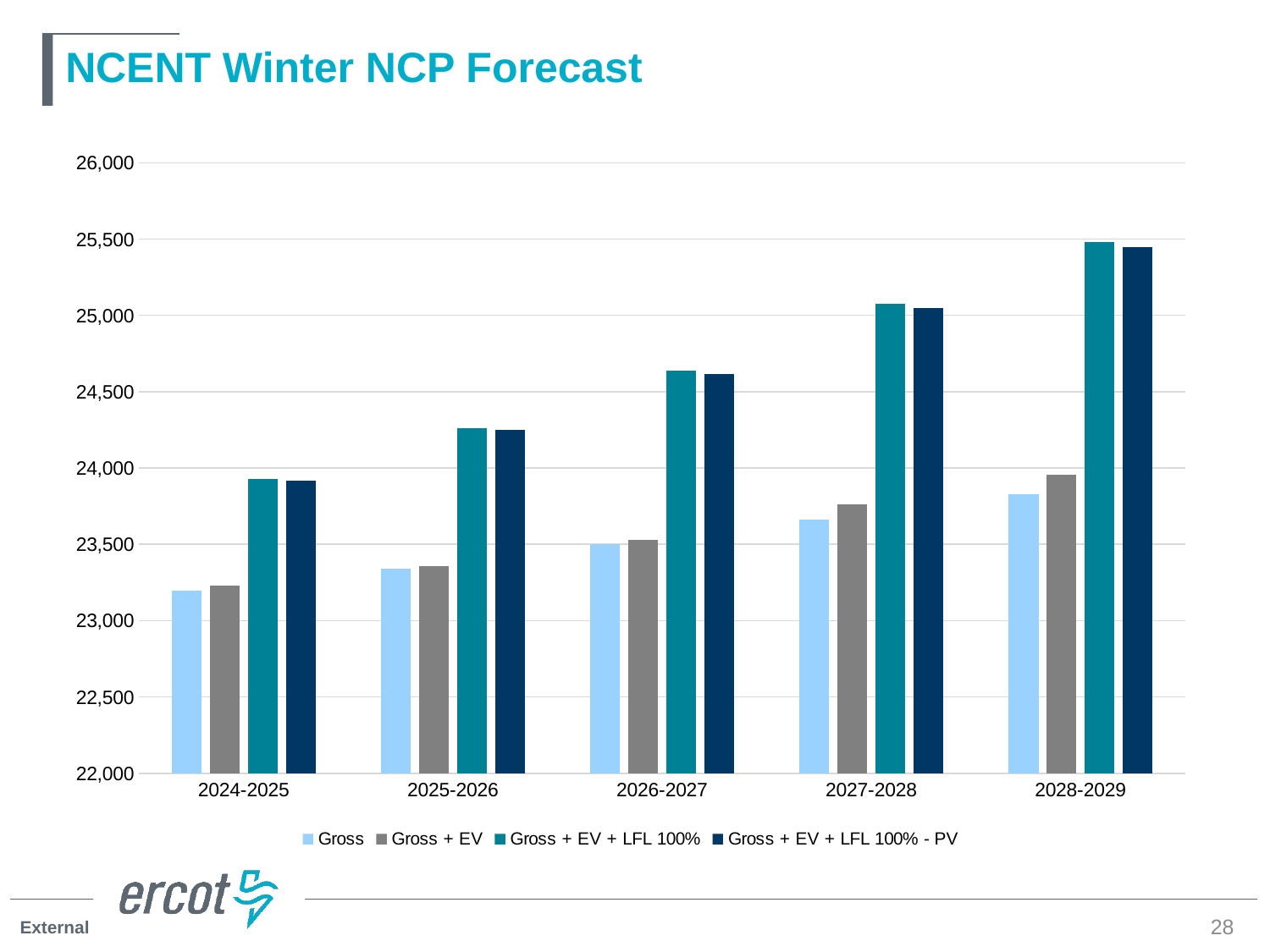
How many series does the legend list? 4 Is the Gross + EV + LFL 100% value for 2028-2029 greater or less than 25,000? greater Is the Gross + EV + LFL 100% value for 2025-2026 greater or less than 24,000? greater Which is larger: the Gross value for 2026-2027 or the Gross + EV + LFL 100% value for 2024-2025? Gross + EV + LFL 100% for 2024-2025 Which winter season has the highest Gross value? 2028-2029 Is the Gross + EV + LFL 100% value for 2026-2027 greater or less than 24,500? greater Which winter season has the lowest Gross + EV + LFL 100% value? 2024-2025 Do the Gross values rise or fall from 2024-2025 to 2028-2029? rise What kind of chart is shown on the slide? bar chart How many winter seasons (categories) are shown on the x axis? 5